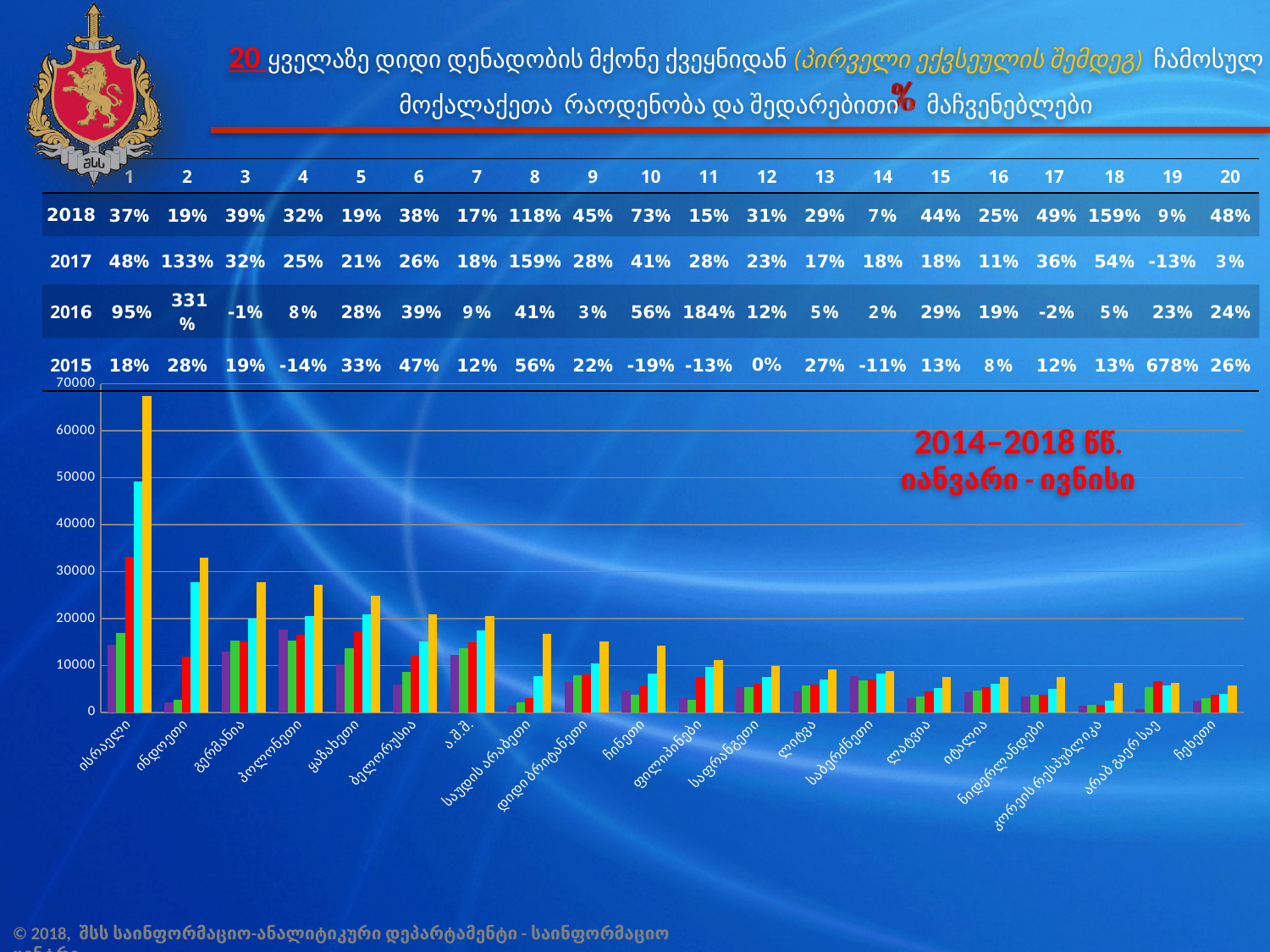
Do the yellow bars generally rise or fall moving from left to right along the x axis? fall How many countries (categories) are shown along the x axis of the bar chart? 20 What is the highest value shown on the chart's vertical axis? 70000 Which has the taller yellow bar, ისრაელი or ინდოეთი? ისრაელი Is the yellow bar for გერმანია greater or less than 30000? less Is the tallest (yellow) bar for ისრაელი greater or less than 60000? greater Is the yellow bar for ყაზახეთი greater or less than 20000? greater What kind of chart is shown on the slide? bar chart Which country has the tallest bar in the chart? ისრაელი How many bars are plotted for each country in the bar chart? 5